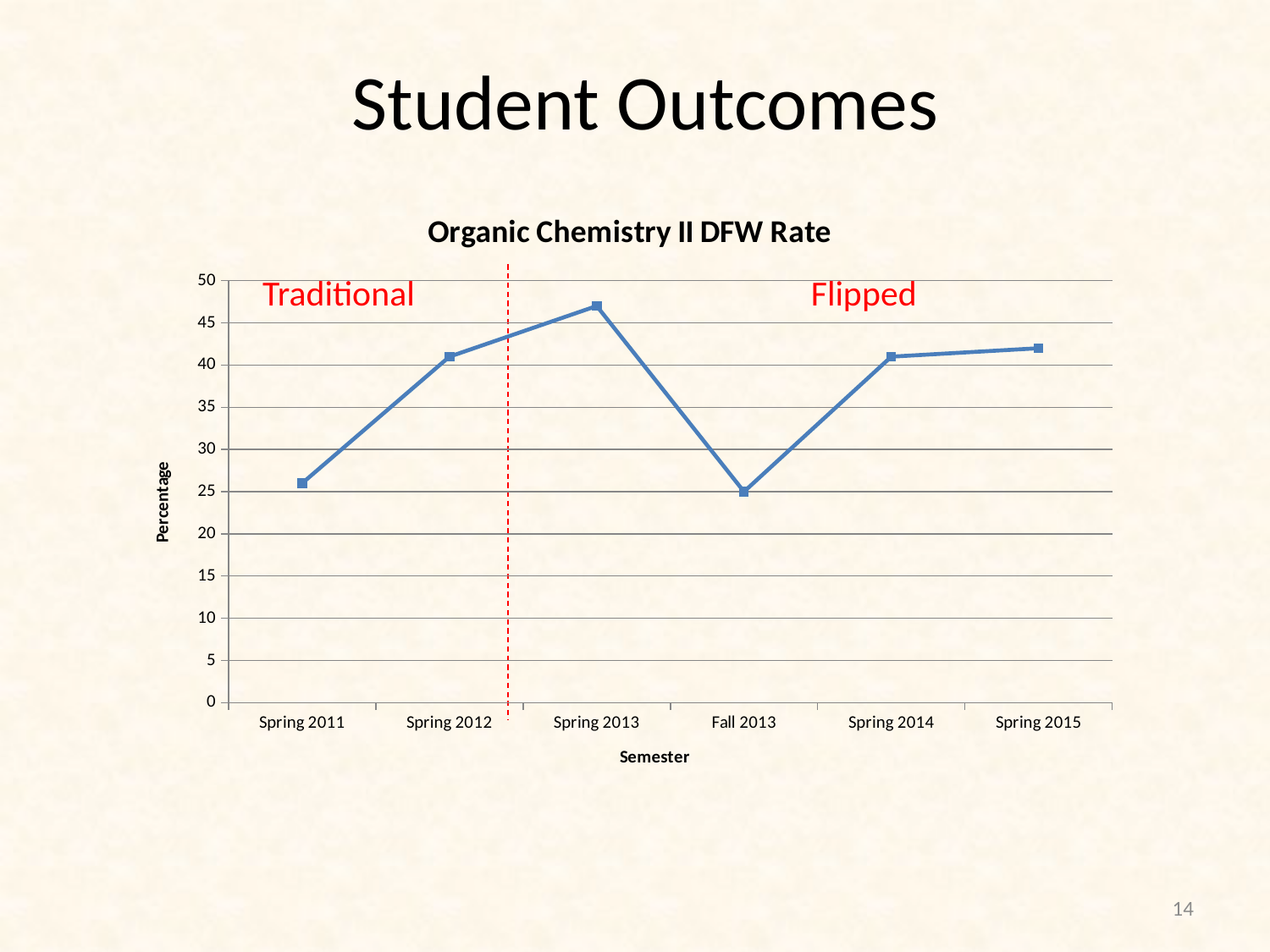
Is the value for Spring 2014 greater or less than 35? greater What type of chart is shown on the slide? line chart Which semester has the highest DFW rate? Spring 2013 How many semesters are plotted on the x axis? 6 What label is shown on the y axis of the chart? Percentage Is the value for Spring 2011 greater or less than 30? less What is the DFW rate for Fall 2013? 25 Is the value for Spring 2015 greater or less than 35? greater What is the title of the chart? Organic Chemistry II DFW Rate Which has a higher DFW rate, Spring 2013 or Fall 2013? Spring 2013 Does the DFW rate rise or fall from Spring 2011 to Spring 2013? rise